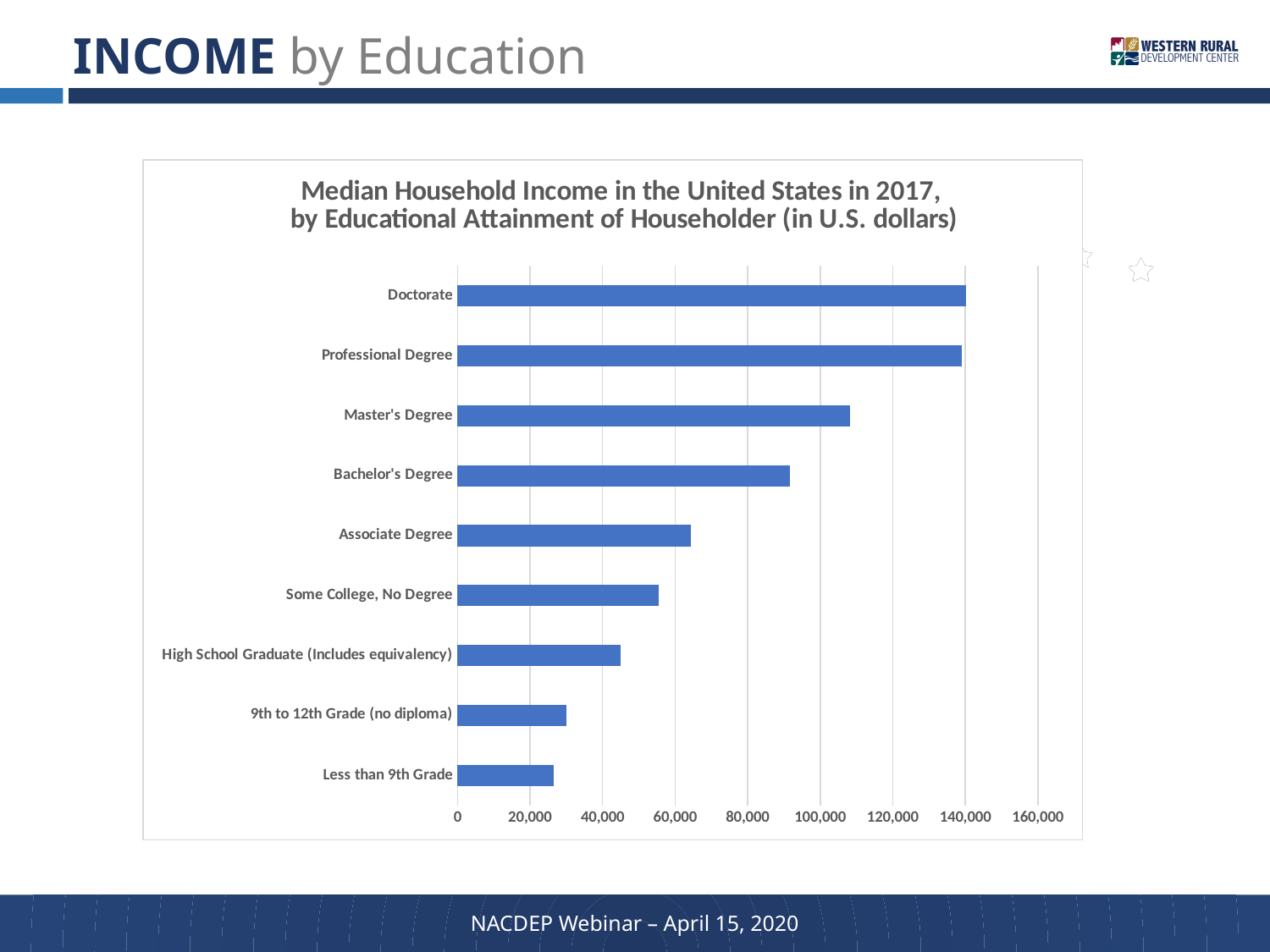
Is the value for Master's Degree greater or less than 100,000? greater Which education category has the lowest median household income in the chart? Less than 9th Grade Is the value for Some College, No Degree greater or less than 60,000? less Is the value for Less than 9th Grade greater or less than 20,000? greater How many education categories are plotted in the chart? 9 What is the title of the chart? Median Household Income in the United States in 2017, by Educational Attainment of Householder (in U.S. dollars) Which has a higher median household income, Master's Degree or Bachelor's Degree? Master's Degree Which has a higher median household income, Associate Degree or High School Graduate (Includes equivalency)? Associate Degree What kind of chart is shown on the slide? bar chart